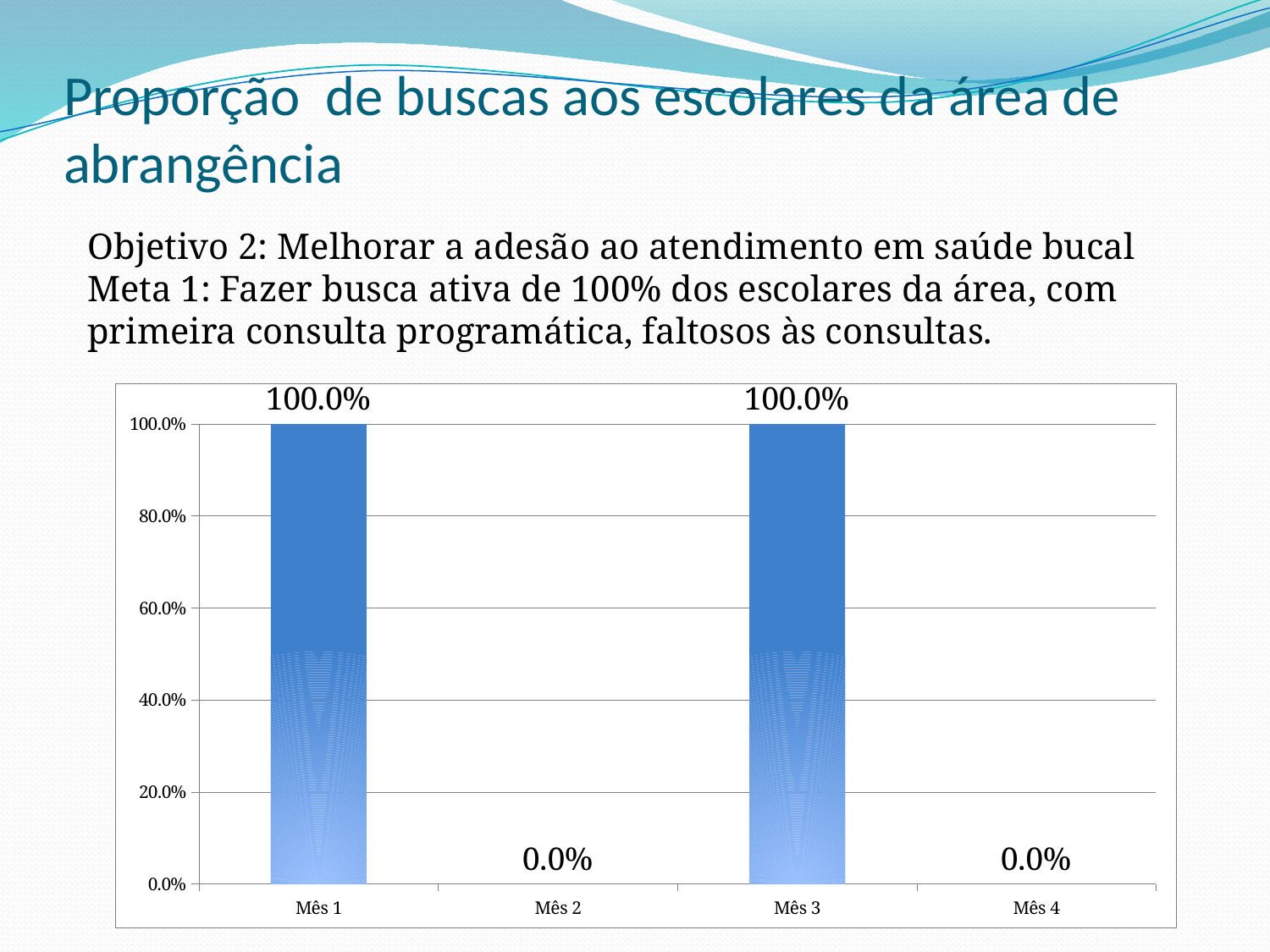
What is the value for Mês 2? 0.0% Is the value for Mês 3 greater or less than 80.0%? greater What is the value for Mês 3? 100.0% What is the value for Mês 4? 0.0% What is the difference between the values for Mês 1 and Mês 2? 100.0% Which of Mês 3 and Mês 4 has the larger value? Mês 3 How many months are shown on the x axis? 4 What is the value for Mês 1? 100.0% What is the highest value labelled on the vertical axis? 100.0% What kind of chart is shown on the slide? bar chart Does the value rise or fall from Mês 1 to Mês 2? fall Which of Mês 1 and Mês 2 has the larger value? Mês 1